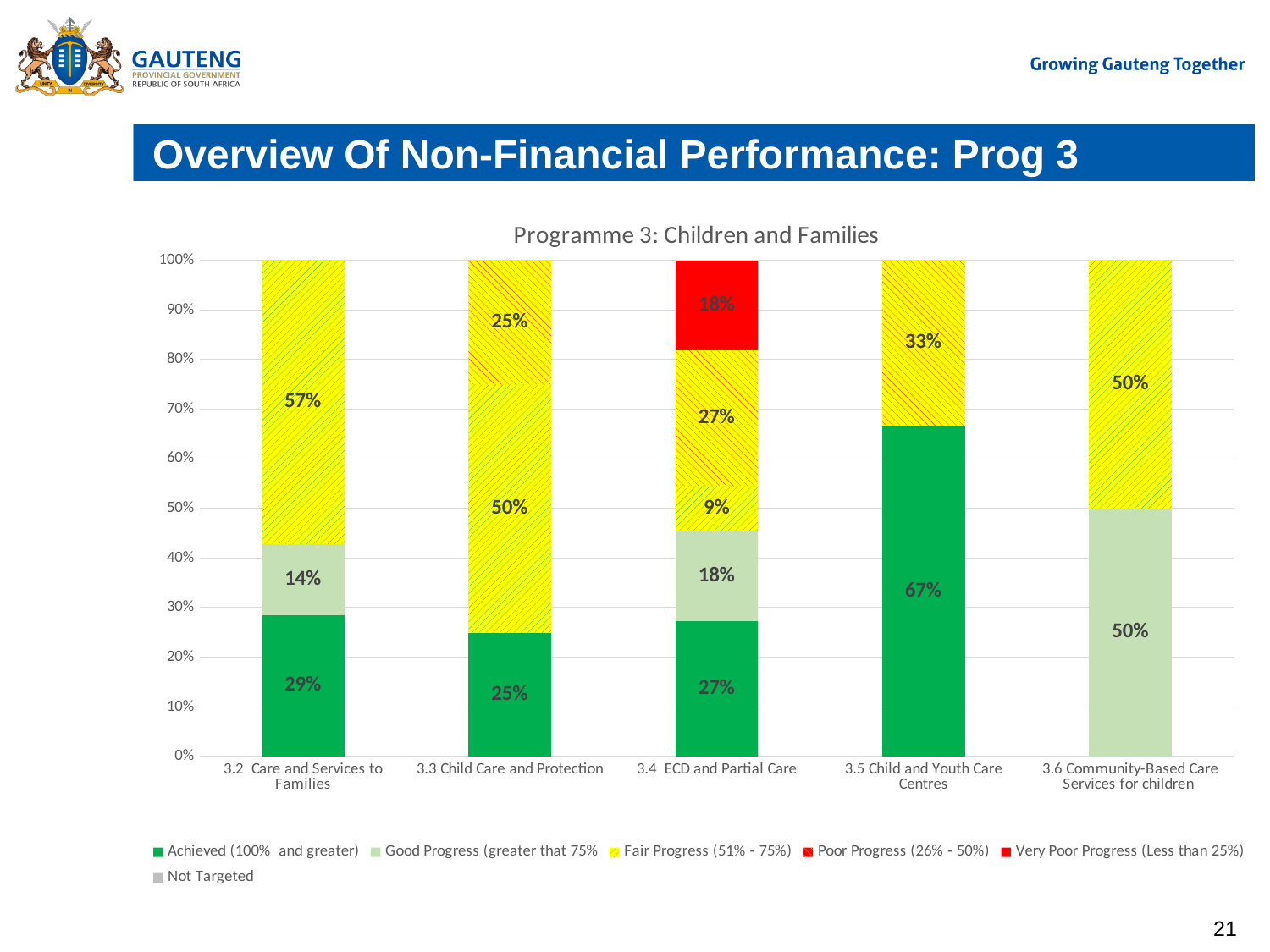
What is the Good Progress value for 3.4 ECD and Partial Care? 18% How many categories (sub-programmes) are shown on the x axis? 5 What is the difference between the Achieved share for 3.5 Child and Youth Care Centres and 3.3 Child Care and Protection? 42% What is the Achieved (100% and greater) value for 3.5 Child and Youth Care Centres? 67% How many series does the legend list? 6 Which is larger: the Good Progress share for 3.6 Community-Based Care Services for children or for 3.2 Care and Services to Families? 3.6 Community-Based Care Services for children What is the title of the chart? Programme 3: Children and Families What is the Very Poor Progress (Less than 25%) value for 3.4 ECD and Partial Care? 18% Which category has the highest Achieved (100% and greater) share? 3.5 Child and Youth Care Centres Which category has the lowest Achieved (100% and greater) share? 3.6 Community-Based Care Services for children What type of chart is shown on the slide? Stacked bar chart What is the Achieved (100% and greater) value for 3.2 Care and Services to Families? 29%